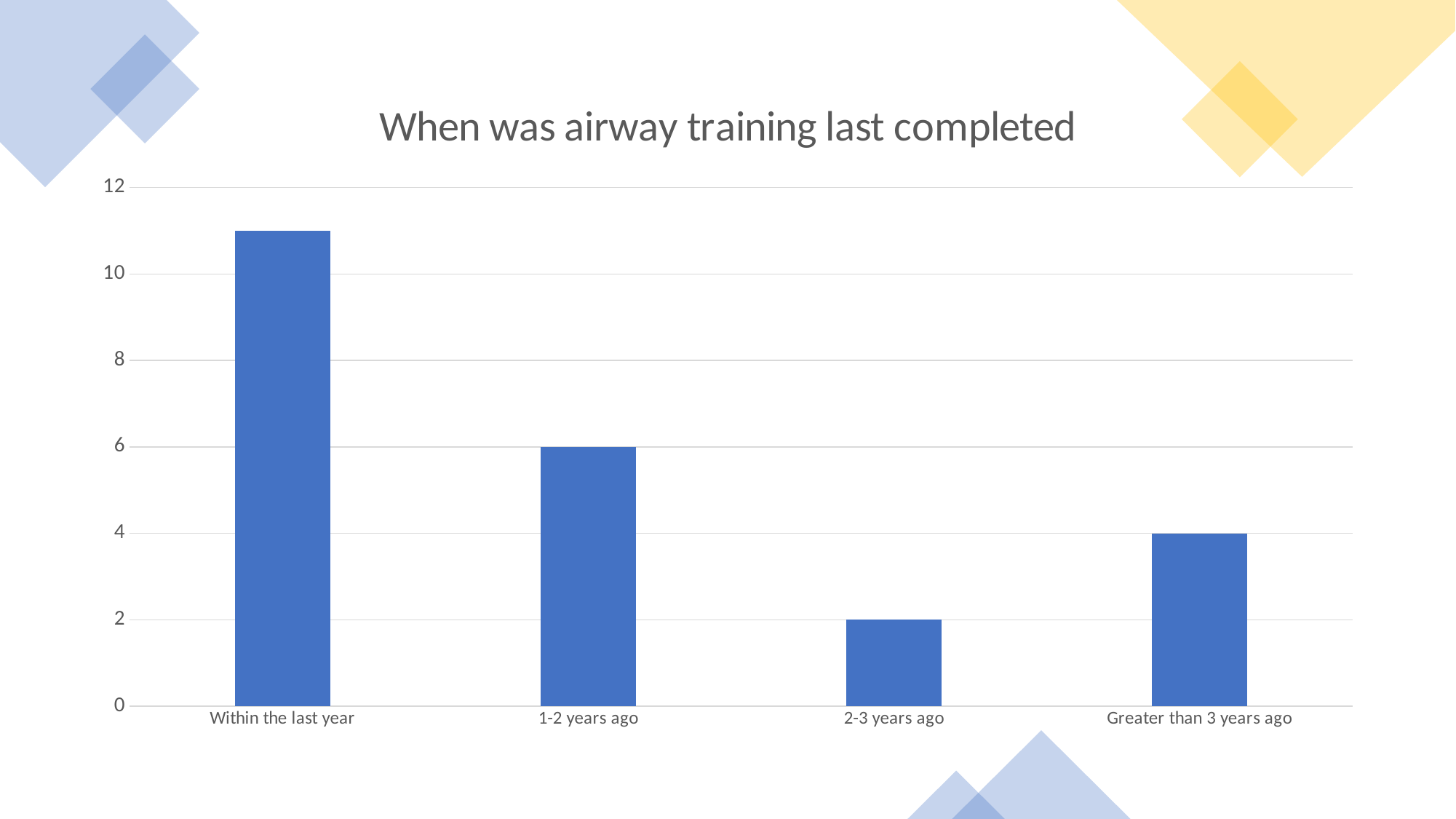
Which is larger, the value for "1-2 years ago" or the value for "Greater than 3 years ago"? 1-2 years ago Which category has the highest value? Within the last year Is the value for "Within the last year" greater or less than 10? greater Which category has the lowest value? 2-3 years ago How many categories are shown on the x axis? 4 What is the title of the chart? When was airway training last completed What is the value for "2-3 years ago"? 2 What is the value for "1-2 years ago"? 6 What is the difference between the values for "1-2 years ago" and "Greater than 3 years ago"? 2 What type of chart is shown on the slide? Bar chart What is the difference between the values for "1-2 years ago" and "2-3 years ago"? 4 What is the value for "Greater than 3 years ago"? 4